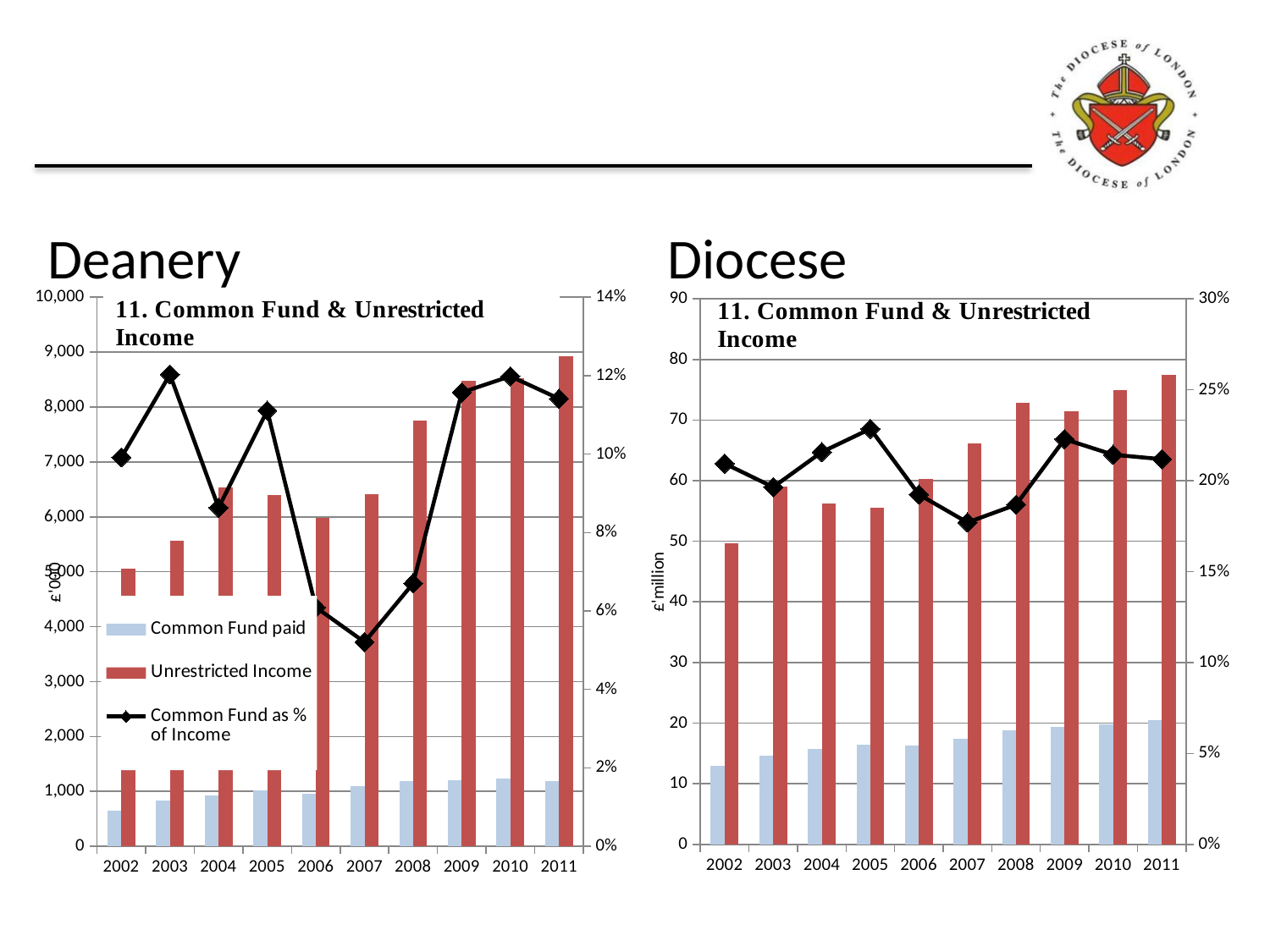
In the Diocese chart, which year has the lowest Unrestricted Income? 2002 In the Deanery chart, which year has the lowest Common Fund as % of Income? 2007 What is the y-axis label on the left side of the Diocese chart? £'million What kind of chart is the Deanery chart on the left? A combined bar and line chart In the Deanery chart, is the Common Fund as % of Income for 2007 greater or less than 6%? less In the Deanery chart, which year has the highest Unrestricted Income? 2011 In the Diocese chart, does Common Fund paid rise or fall from 2002 to 2011? rise In the Deanery chart, is the Unrestricted Income for 2011 greater or less than 8,000? greater In the Deanery chart, which year has the highest Common Fund as % of Income? 2003 How many years are shown on the x axis of the Diocese chart? 10 How many series does the legend of the Deanery chart list? 3 In the Diocese chart, is the Unrestricted Income for 2011 greater or less than 70? greater